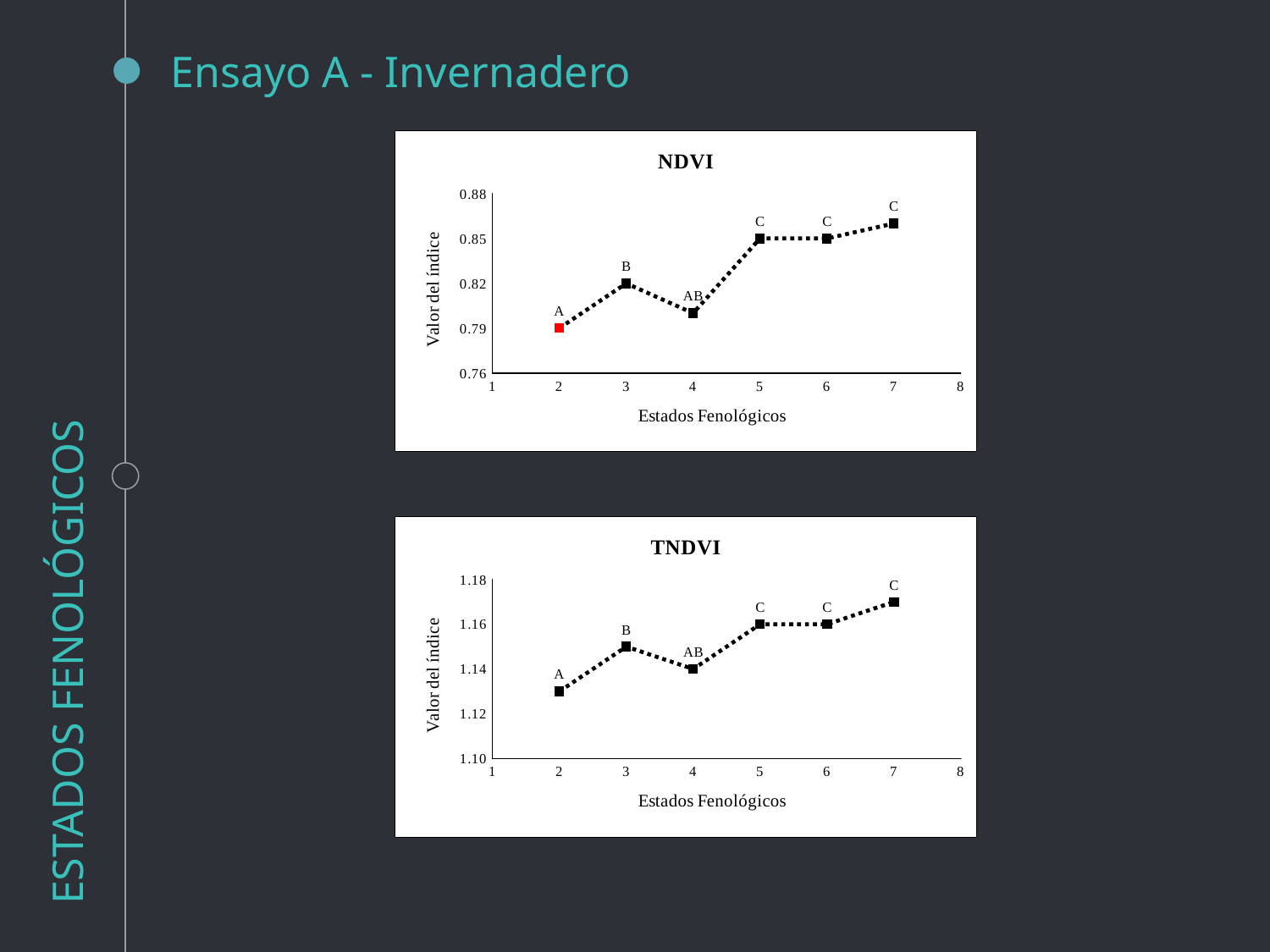
In the NDVI chart, is the value at phenological state 4 greater or less than 0.82? less In the NDVI chart, what is the value at phenological state 2? 0.79 In the TNDVI chart, how many data points are plotted? 6 In the TNDVI chart, is the value at phenological state 7 greater or less than 1.16? greater What kind of chart is the TNDVI chart? line chart In the TNDVI chart, what is the value at phenological state 4? 1.14 In the TNDVI chart, is the value at phenological state 2 greater or less than 1.14? less In the NDVI chart, which phenological state has the lowest value? 2 In the NDVI chart, which phenological state has the highest value? 7 In the NDVI chart, what letter label is shown above the point at phenological state 4? AB In the NDVI chart, what is the value at phenological state 5? 0.85 In the NDVI chart, what is the value at phenological state 3? 0.82